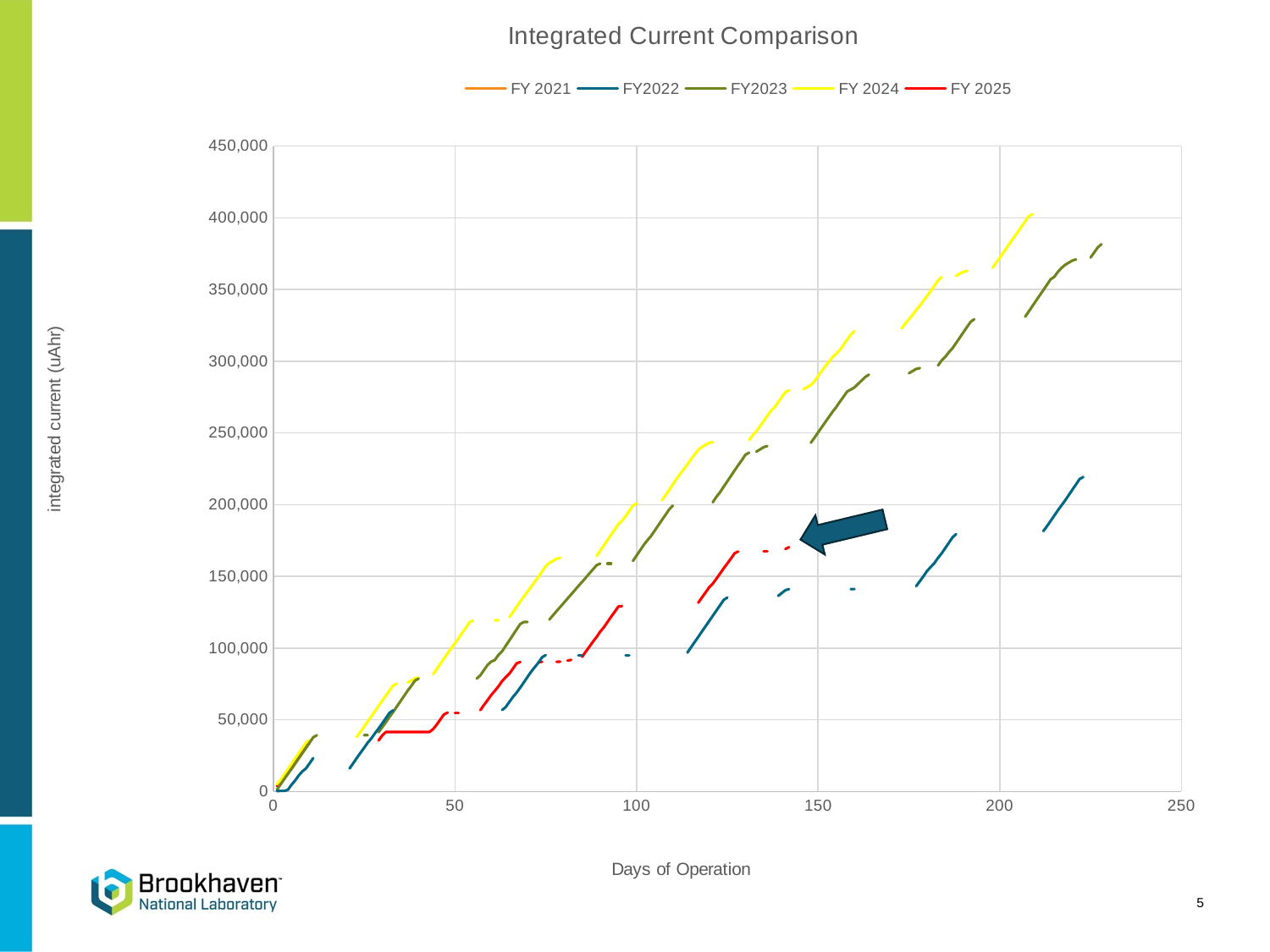
Does the FY 2024 series rise or fall as Days of Operation increases? rise What is the title of the chart? Integrated Current Comparison How many series does the legend list? 5 Is the highest value reached by the FY2023 series greater or less than 350,000? greater Is the highest value reached by the FY 2024 series greater or less than 350,000? greater What is the label of the y axis? integrated current (uAhr) Is the highest value reached by the FY 2025 series greater or less than 150,000? greater What kind of chart is shown on the slide? line chart At 100 Days of Operation, which series has the larger integrated current, FY 2024 or FY2022? FY 2024